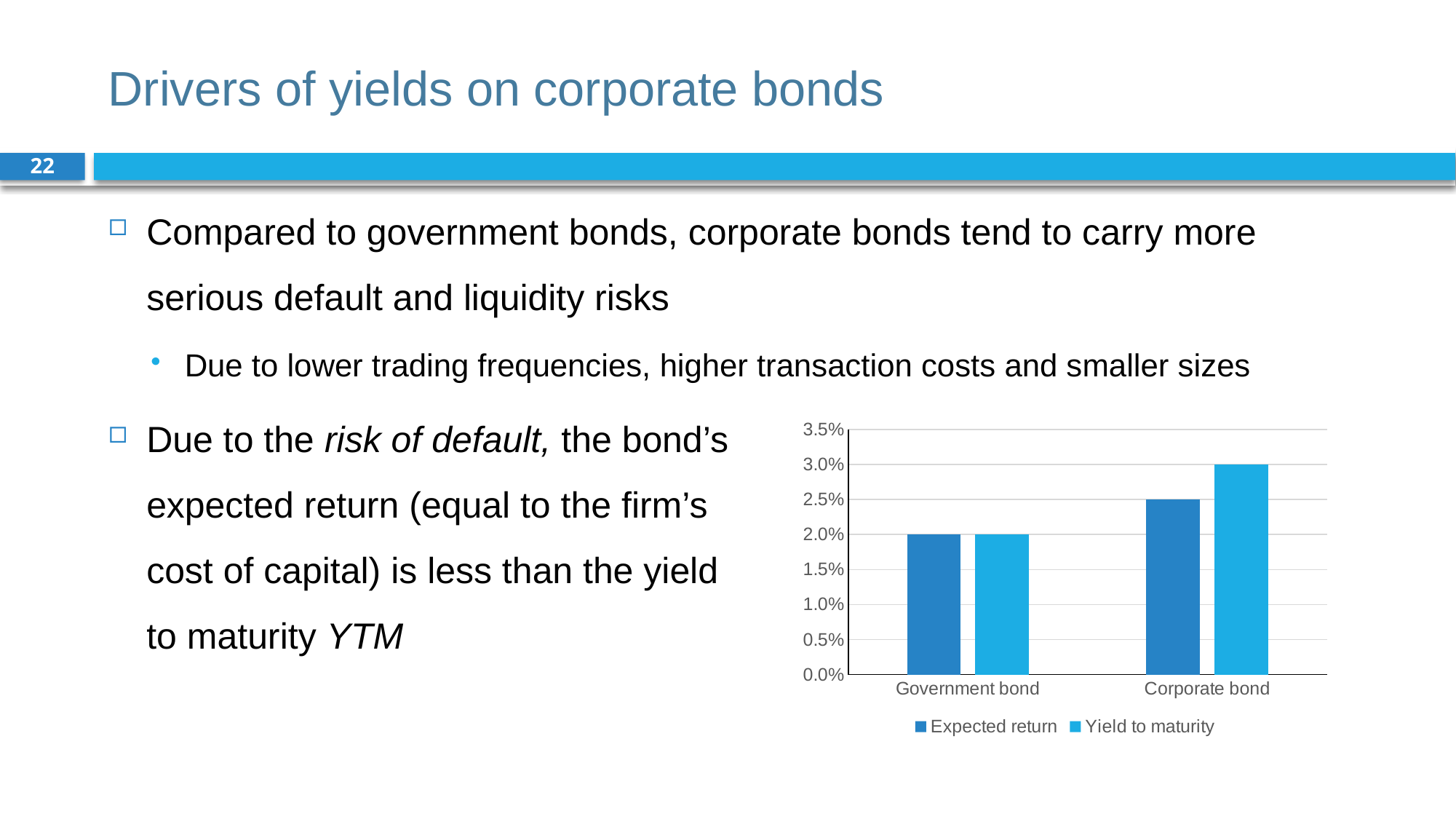
What is the difference between the Yield to maturity and the Expected return for the Corporate bond? 0.5% What is the Yield to maturity for the Corporate bond? 3.0% Which series is shown in the lighter blue colour in the chart? Yield to maturity For the Corporate bond, which is larger: Expected return or Yield to maturity? Yield to maturity What is the Expected return for the Corporate bond? 2.5% How many series does the chart legend list? 2 What is the Expected return for the Government bond? 2.0% Which category has the highest Yield to maturity? Corporate bond How many categories are shown on the x axis of the chart? 2 What kind of chart is shown on the slide? bar chart Which category has the lowest Expected return? Government bond What is the Yield to maturity for the Government bond? 2.0%